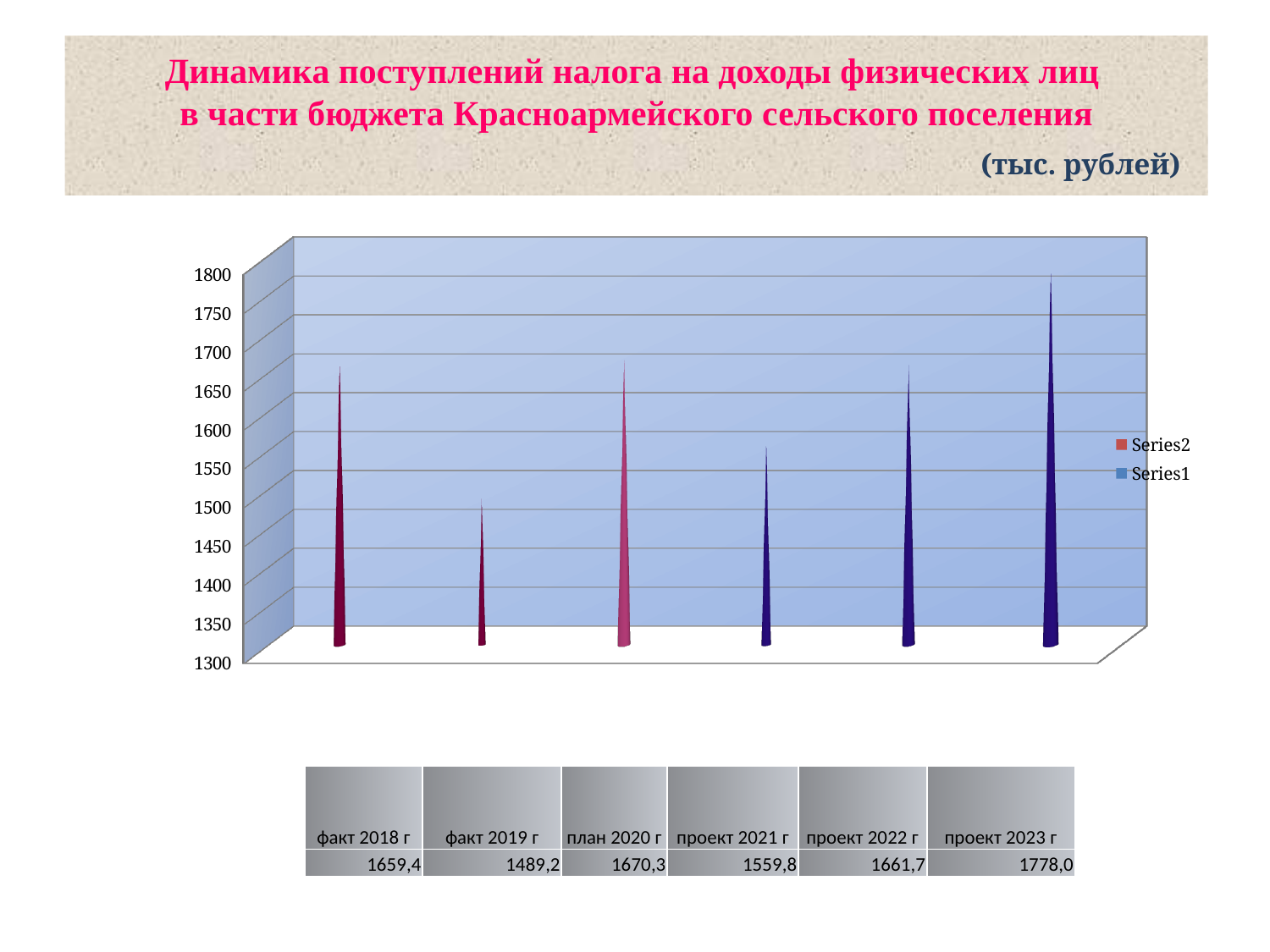
What is the difference between the values for проект 2023 г and факт 2019 г? 288,8 Which is larger, the value for факт 2018 г or the value for проект 2022 г? проект 2022 г What is the value for план 2020 г? 1670,3 Which category has the lowest value? факт 2019 г Which category has the highest value? проект 2023 г What is the value for факт 2018 г? 1659,4 How many series does the legend list? 2 How many categories are shown on the x axis? 6 What is the difference between the values for план 2020 г and проект 2021 г? 110,5 Is the value for проект 2021 г greater or less than 1600? less What unit is stated in the chart title? тыс. рублей What is the value for проект 2023 г? 1778,0